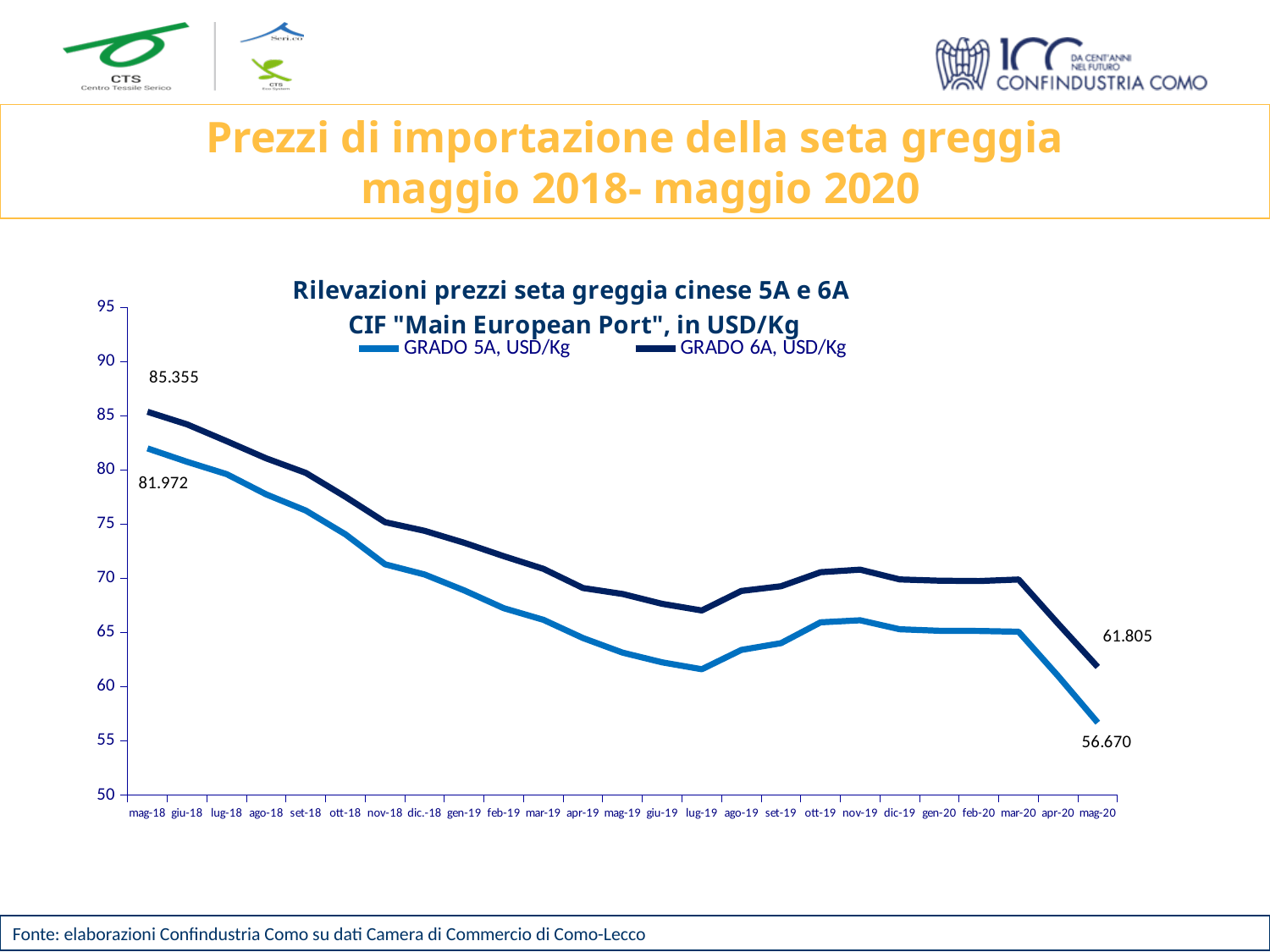
What is the difference between the GRADO 6A and GRADO 5A values at mag-18? 3.383 What is the value of GRADO 6A, USD/Kg at mag-18? 85.355 By how much did the GRADO 6A value fall from mag-18 to mag-20? 23.550 Is the value for GRADO 6A at lug-19 greater or less than 70? less What kind of chart is shown on the slide? Line chart What is the value of GRADO 5A, USD/Kg at mag-18? 81.972 What is the value of GRADO 5A, USD/Kg at mag-20? 56.670 How many series does the legend list? 2 At which month does the GRADO 5A series reach its lowest value? mag-20 What is the difference between the GRADO 6A and GRADO 5A values at mag-20? 5.135 What is the value of GRADO 6A, USD/Kg at mag-20? 61.805 Which series has the higher value at mag-18, GRADO 5A or GRADO 6A? GRADO 6A